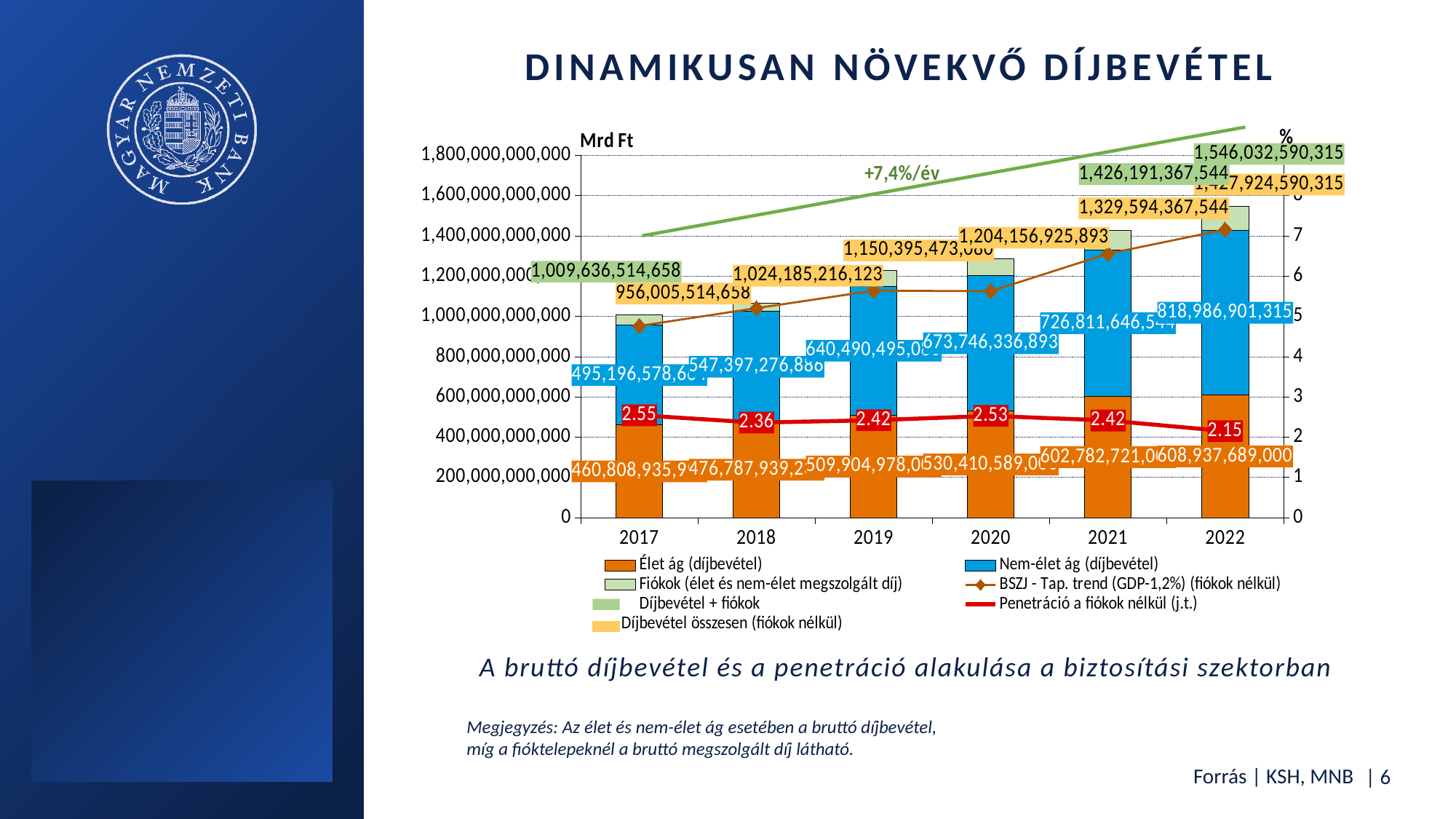
How many years are shown on the x axis of the chart? 6 What is the value of the Penetráció a fiókok nélkül (j.t.) line for 2017? 2.55 What is the Díjbevétel összesen (fiókok nélkül) value for 2022? 1,427,924,590,315 What is the Élet ág (díjbevétel) value for 2022? 608,937,689,000 Which is larger in 2022, the Élet ág (díjbevétel) or the Nem-élet ág (díjbevétel)? Nem-élet ág (díjbevétel) In which year is the Penetráció a fiókok nélkül (j.t.) value the lowest? 2022 By how much does the Penetráció a fiókok nélkül (j.t.) value in 2017 exceed the value in 2022? 0.40 What is the Díjbevétel + fiókok value for 2022? 1,546,032,590,315 What is the value of the Penetráció a fiókok nélkül (j.t.) line for 2022? 2.15 What annual growth rate is annotated next to the green trend line? +7,4%/év How many entries does the chart legend list? 7 In which year is the Penetráció a fiókok nélkül (j.t.) value the highest? 2017